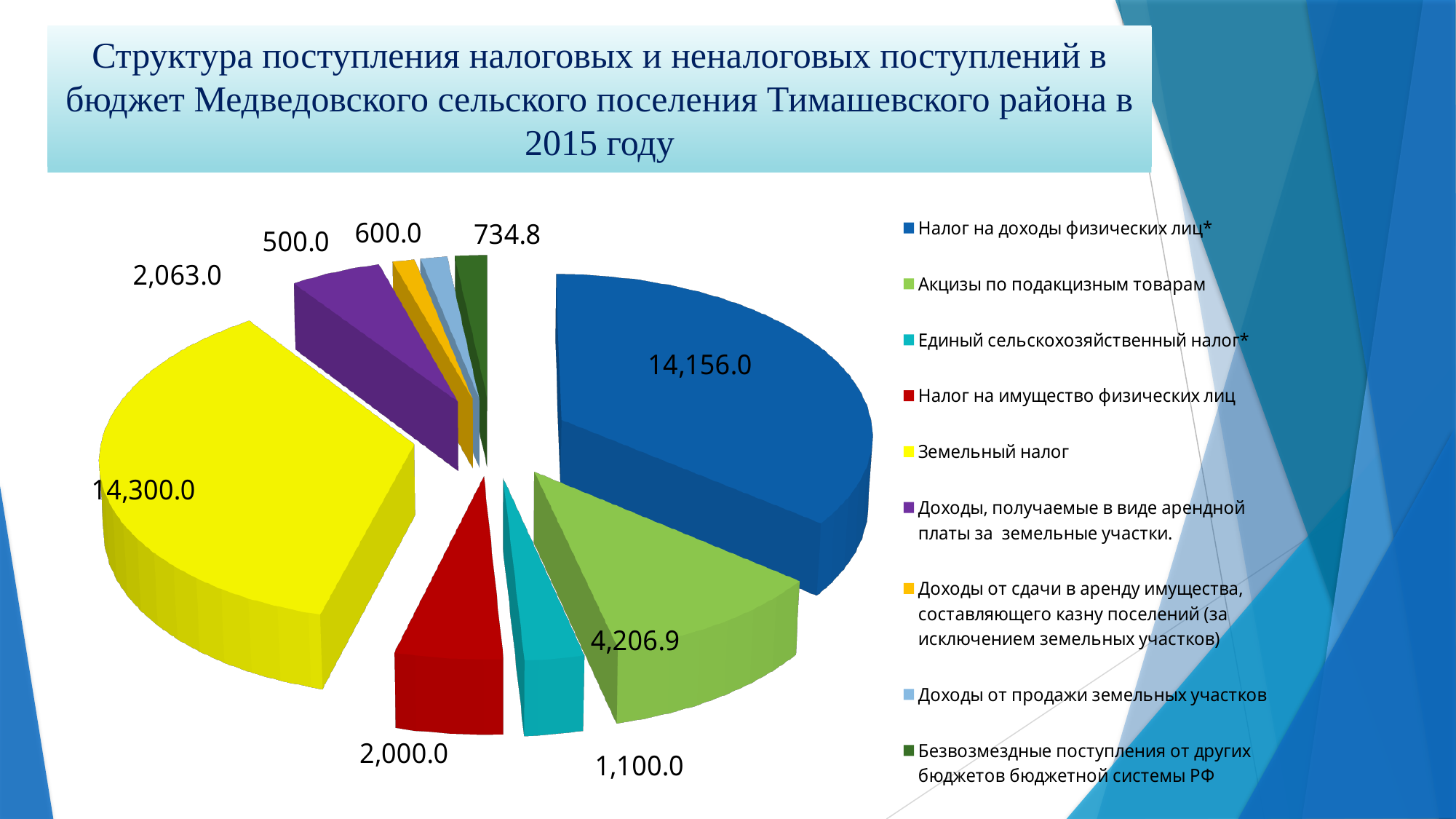
Which is larger: Налог на имущество физических лиц or Доходы, получаемые в виде арендной платы за земельные участки? Доходы, получаемые в виде арендной платы за земельные участки What is the value for Земельный налог? 14,300.0 What is the difference between Акцизы по подакцизным товарам and Единый сельскохозяйственный налог*? 3,106.9 Which category has the largest value? Земельный налог What is the value for Акцизы по подакцизным товарам? 4,206.9 What is the difference between Земельный налог and Налог на доходы физических лиц*? 144.0 What is the value for Безвозмездные поступления от других бюджетов бюджетной системы РФ? 734.8 What is the value for Налог на доходы физических лиц*? 14,156.0 Which category has the smallest value? Доходы от сдачи в аренду имущества, составляющего казну поселений (за исключением земельных участков) How many categories does the legend list? 9 What is the value for Доходы от продажи земельных участков? 600.0 What type of chart is shown on the slide? Pie chart